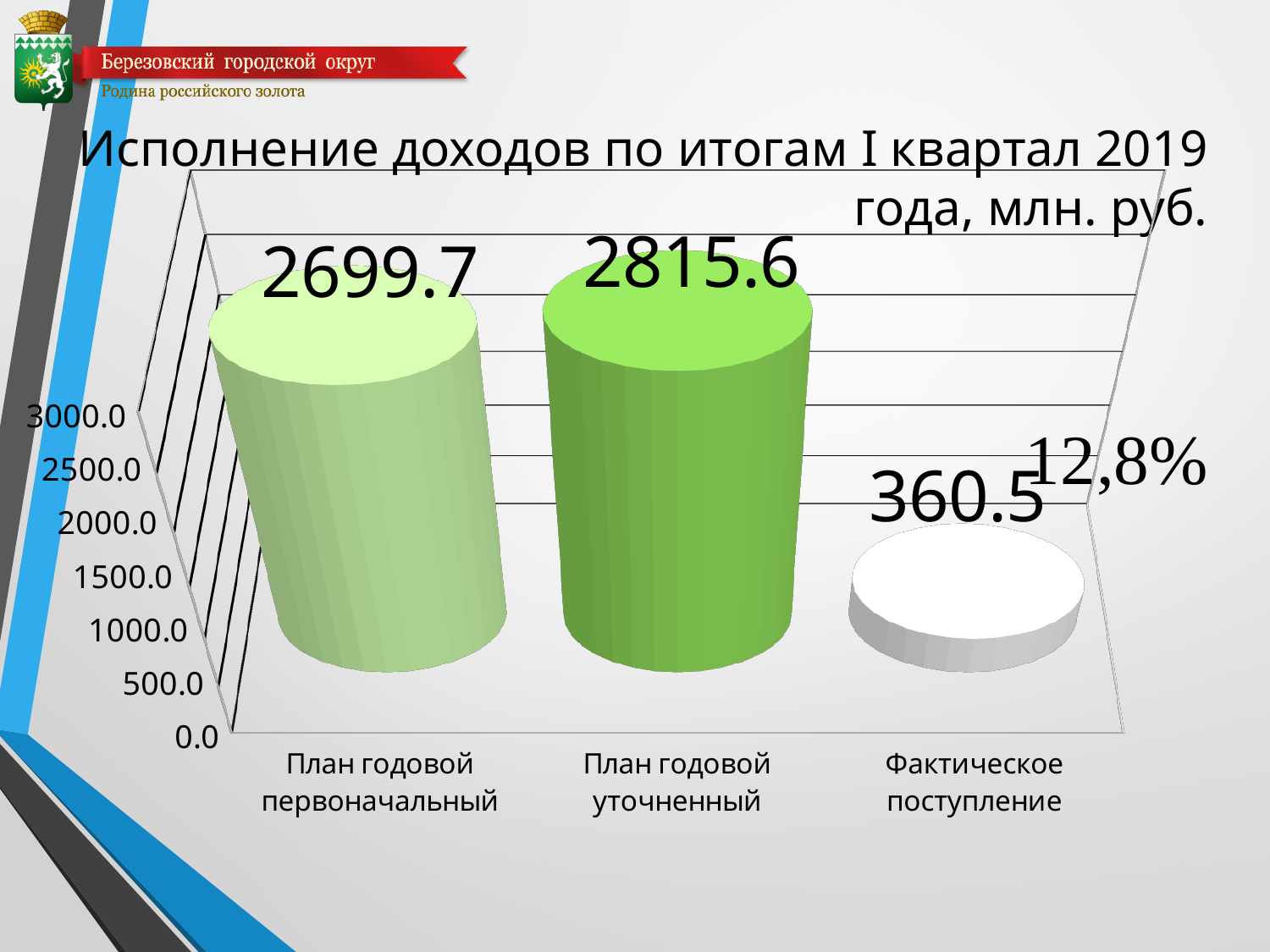
What is the difference between План годовой уточненный and План годовой первоначальный? 115.9 What is the value for План годовой первоначальный? 2699.7 Is the value for Фактическое поступление greater or less than 500.0? less What is the difference between План годовой уточненный and Фактическое поступление? 2455.1 What kind of chart is shown on the slide? bar chart Which is larger, План годовой первоначальный or Фактическое поступление? План годовой первоначальный Which category has the highest value? План годовой уточненный How many categories are shown on the chart? 3 What percentage is printed next to the Фактическое поступление bar? 12,8% What is the value for План годовой уточненный? 2815.6 What is the value for Фактическое поступление? 360.5 Which category has the lowest value? Фактическое поступление